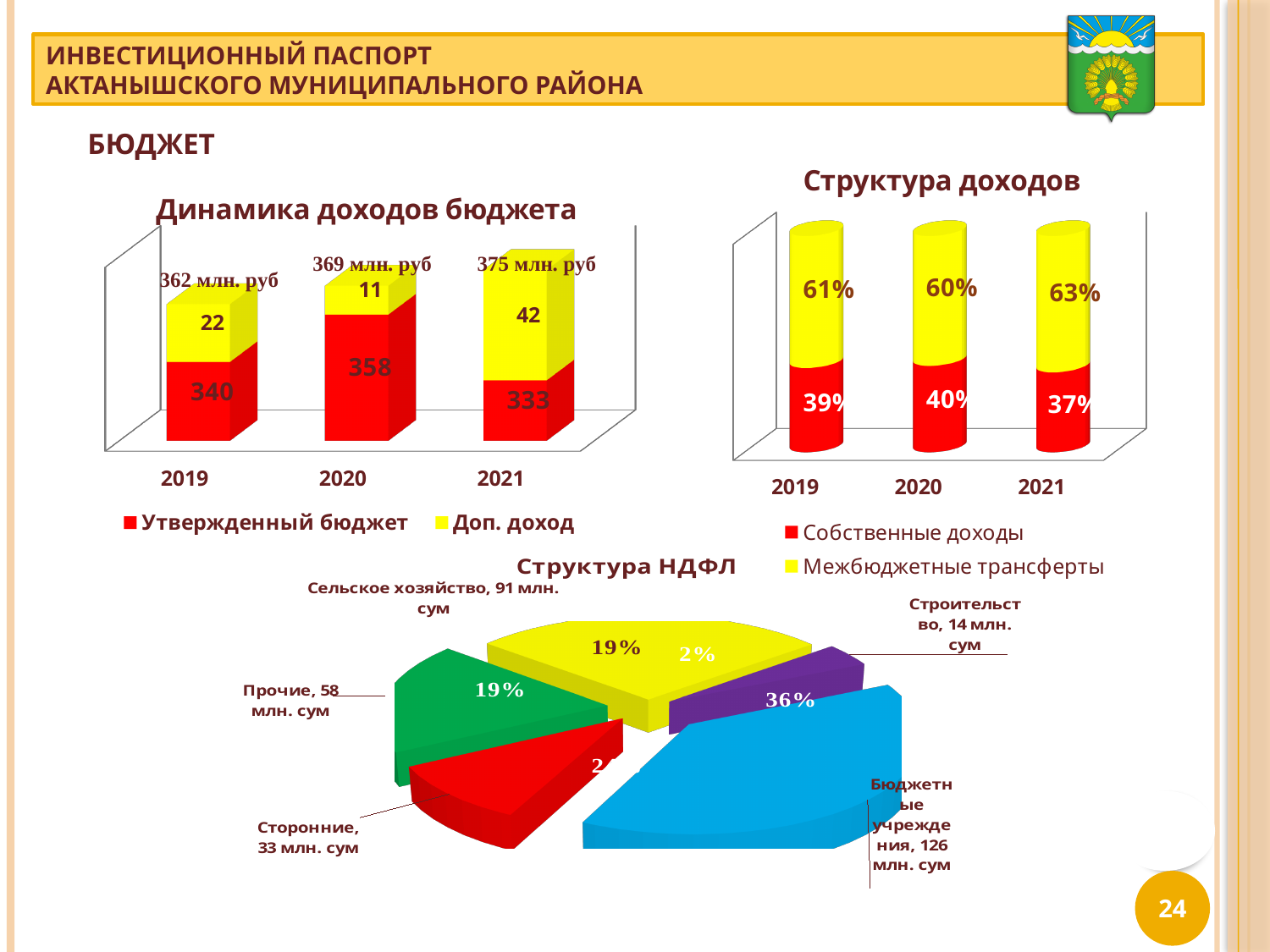
In the chart 'Структура НДФЛ', what is the value for 'Бюджетные учреждения'? 126 млн. сум In the chart 'Структура НДФЛ', which category has the smallest value? Строительство In the chart 'Динамика доходов бюджета', what is the total shown above the bar for 2019? 362 млн. руб In the chart 'Динамика доходов бюджета', which year has the lowest 'Доп. доход' value? 2020 In the chart 'Динамика доходов бюджета', what is the value of 'Доп. доход' for 2021? 42 In the chart 'Динамика доходов бюджета', how many series does the legend list? 2 In the chart 'Структура доходов', is the share of 'Собственные доходы' larger in 2019 or in 2020? 2020 In the chart 'Динамика доходов бюджета', what is the value of 'Утвержденный бюджет' for 2020? 358 In the chart 'Структура доходов', what is the share of 'Собственные доходы' in 2021? 37% In the chart 'Структура доходов', which year has the highest share of 'Межбюджетные трансферты'? 2021 What kind of chart is 'Структура НДФЛ'? Pie chart In the chart 'Динамика доходов бюджета', what is the difference between the 'Утвержденный бюджет' values for 2020 and 2021? 25